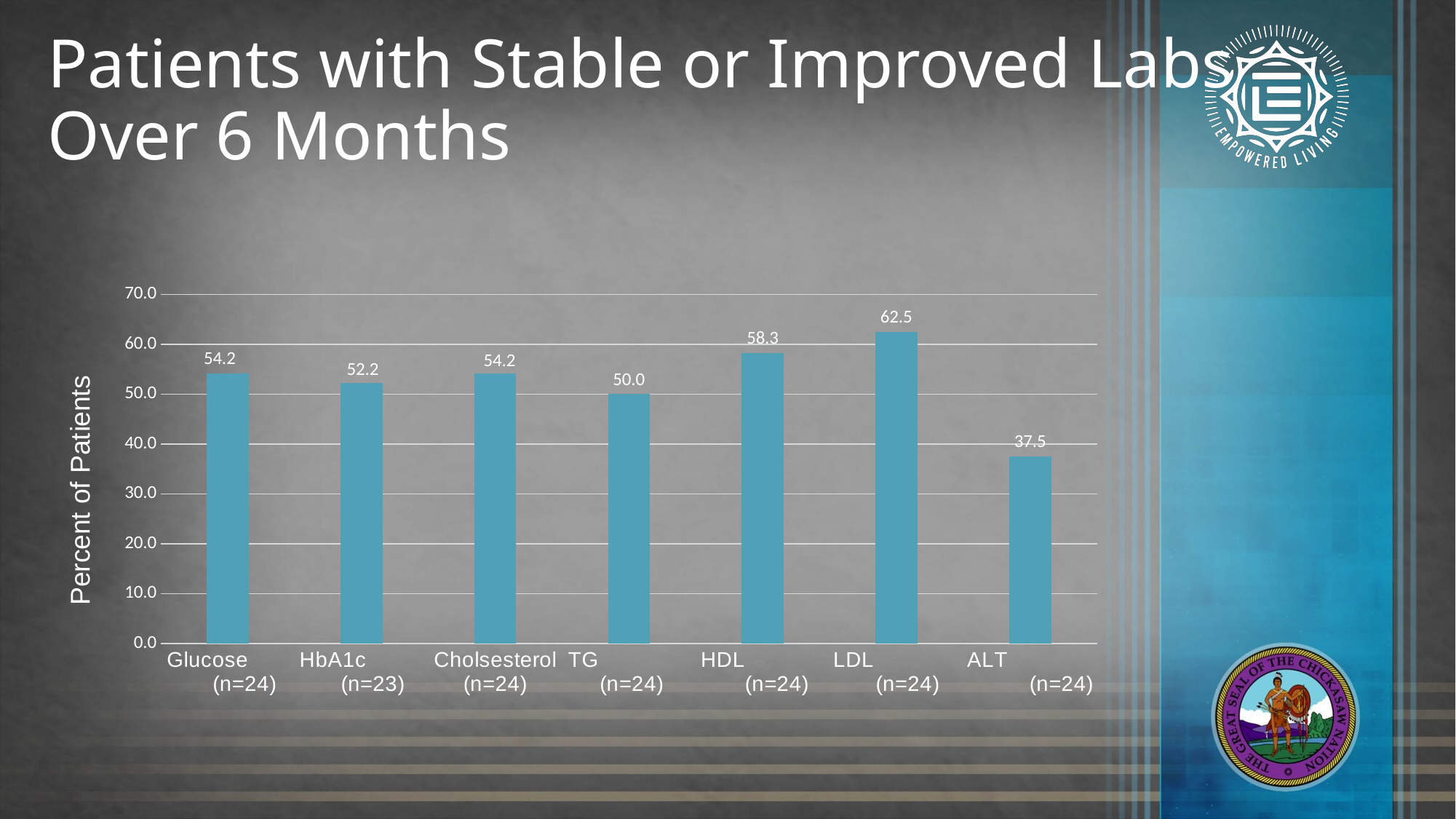
What is the value for ALT (n=24)? 37.5 Which category has the lowest value? ALT (n=24) What is the difference between the values for HDL (n=24) and TG (n=24)? 8.3 What is the value for HbA1c (n=23)? 52.2 Which is larger, the value for HDL (n=24) or the value for Glucose (n=24)? HDL (n=24) Which category has the highest value? LDL (n=24) What is the label of the y axis? Percent of Patients What is the value for TG (n=24)? 50.0 How many categories are shown on the x axis? 7 What kind of chart is shown on the slide? bar chart What is the value for LDL (n=24)? 62.5 What is the difference between the values for LDL (n=24) and ALT (n=24)? 25.0